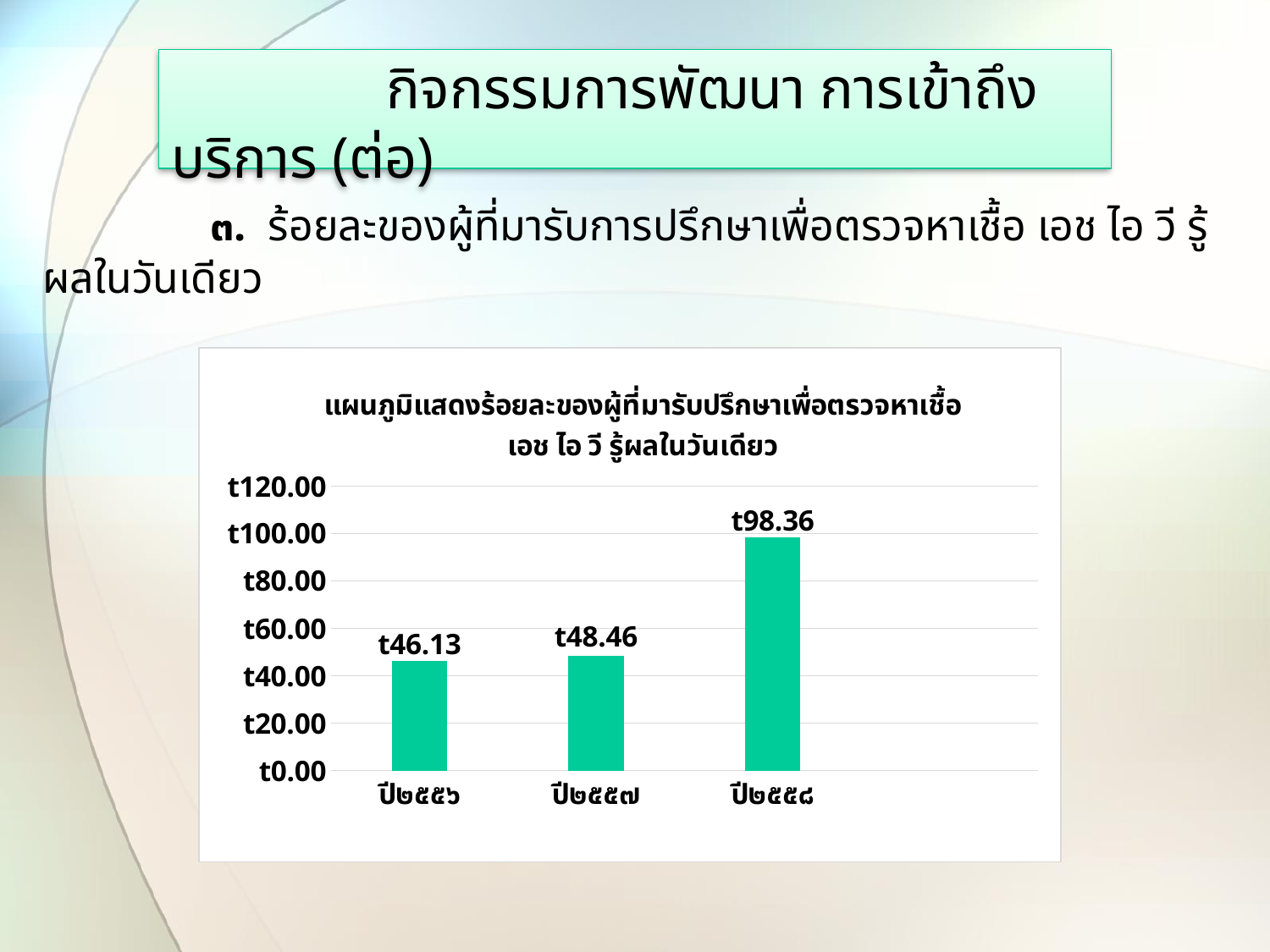
What is the value for ปี๒๕๕๘? t98.36 What is the value for ปี๒๕๕๗? t48.46 What is the difference between the values for ปี๒๕๕๗ and ปี๒๕๕๖? t2.33 Which category has the lowest value? ปี๒๕๕๖ What is the value for ปี๒๕๕๖? t46.13 Which is larger, the value for ปี๒๕๕๖ or the value for ปี๒๕๕๗? ปี๒๕๕๗ What is the difference between the values for ปี๒๕๕๘ and ปี๒๕๕๗? t49.90 Which category has the highest value? ปี๒๕๕๘ What kind of chart is shown on the slide? bar chart Is the value for ปี๒๕๕๘ greater or less than t80.00? greater Do the values rise or fall from ปี๒๕๕๖ to ปี๒๕๕๘? rise How many categories are shown on the x axis? 3